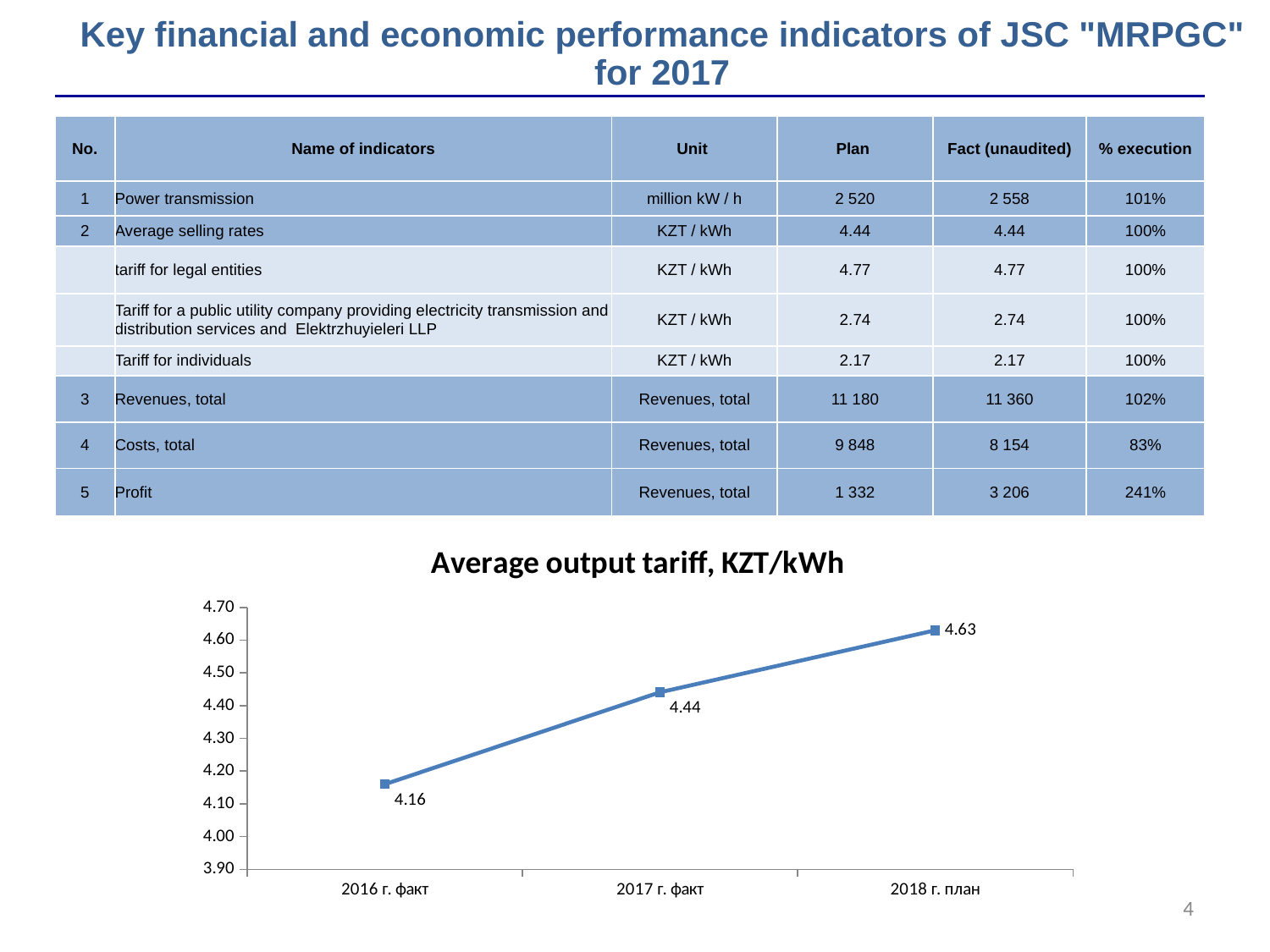
How many data points are plotted in the Average output tariff chart? 3 What kind of chart is the Average output tariff chart? line chart What is the difference between the 2017 г. факт and 2016 г. факт values in the Average output tariff chart? 0.28 What is the value for 2016 г. факт in the Average output tariff chart? 4.16 What is the value for 2018 г. план in the Average output tariff chart? 4.63 Which category has the lowest value in the Average output tariff chart? 2016 г. факт Which category has the highest value in the Average output tariff chart? 2018 г. план What is the difference between the 2018 г. план and 2017 г. факт values in the Average output tariff chart? 0.19 What is the value for 2017 г. факт in the Average output tariff chart? 4.44 Do the values in the Average output tariff chart rise or fall from 2016 г. факт to 2018 г. план? rise Which is larger in the Average output tariff chart, the value for 2016 г. факт or 2018 г. план? 2018 г. план Is the value for 2017 г. факт in the Average output tariff chart greater or less than 4.50? less